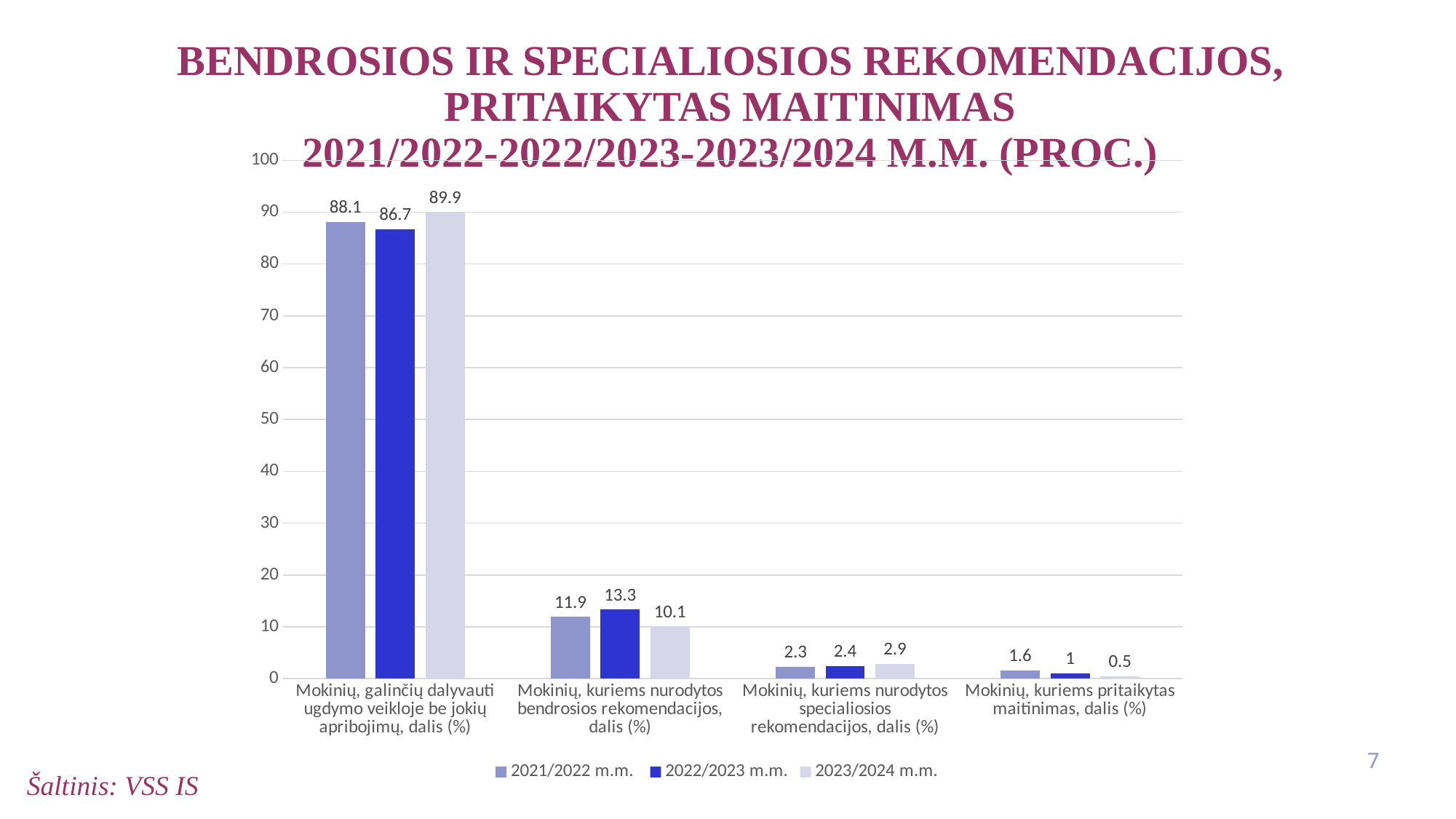
What is the value for "Mokinių, kuriems nurodytos bendrosios rekomendacijos, dalis (%)" in the 2022/2023 m.m. series? 13.3 Which category has the lowest value in the 2023/2024 m.m. series? Mokinių, kuriems pritaikytas maitinimas, dalis (%) How many categories are shown on the x axis of the chart? 4 What is the value for "Mokinių, kuriems pritaikytas maitinimas, dalis (%)" in the 2021/2022 m.m. series? 1.6 What is the difference between the 2021/2022 m.m. and 2023/2024 m.m. values for "Mokinių, kuriems nurodytos bendrosios rekomendacijos, dalis (%)"? 1.8 What kind of chart is shown on the slide? bar chart Is the 2022/2023 m.m. value for "Mokinių, galinčių dalyvauti ugdymo veikloje be jokių apribojimų, dalis (%)" greater or less than 80? greater How many series does the legend list? 3 Which category has the highest value in the 2022/2023 m.m. series? Mokinių, galinčių dalyvauti ugdymo veikloje be jokių apribojimų, dalis (%) What is the value for "Mokinių, galinčių dalyvauti ugdymo veikloje be jokių apribojimų, dalis (%)" in the 2023/2024 m.m. series? 89.9 Across the three school years, do the values for "Mokinių, kuriems pritaikytas maitinimas, dalis (%)" rise or fall? fall For "Mokinių, kuriems nurodytos specialiosios rekomendacijos, dalis (%)", which series has the larger value: 2021/2022 m.m. or 2023/2024 m.m.? 2023/2024 m.m.